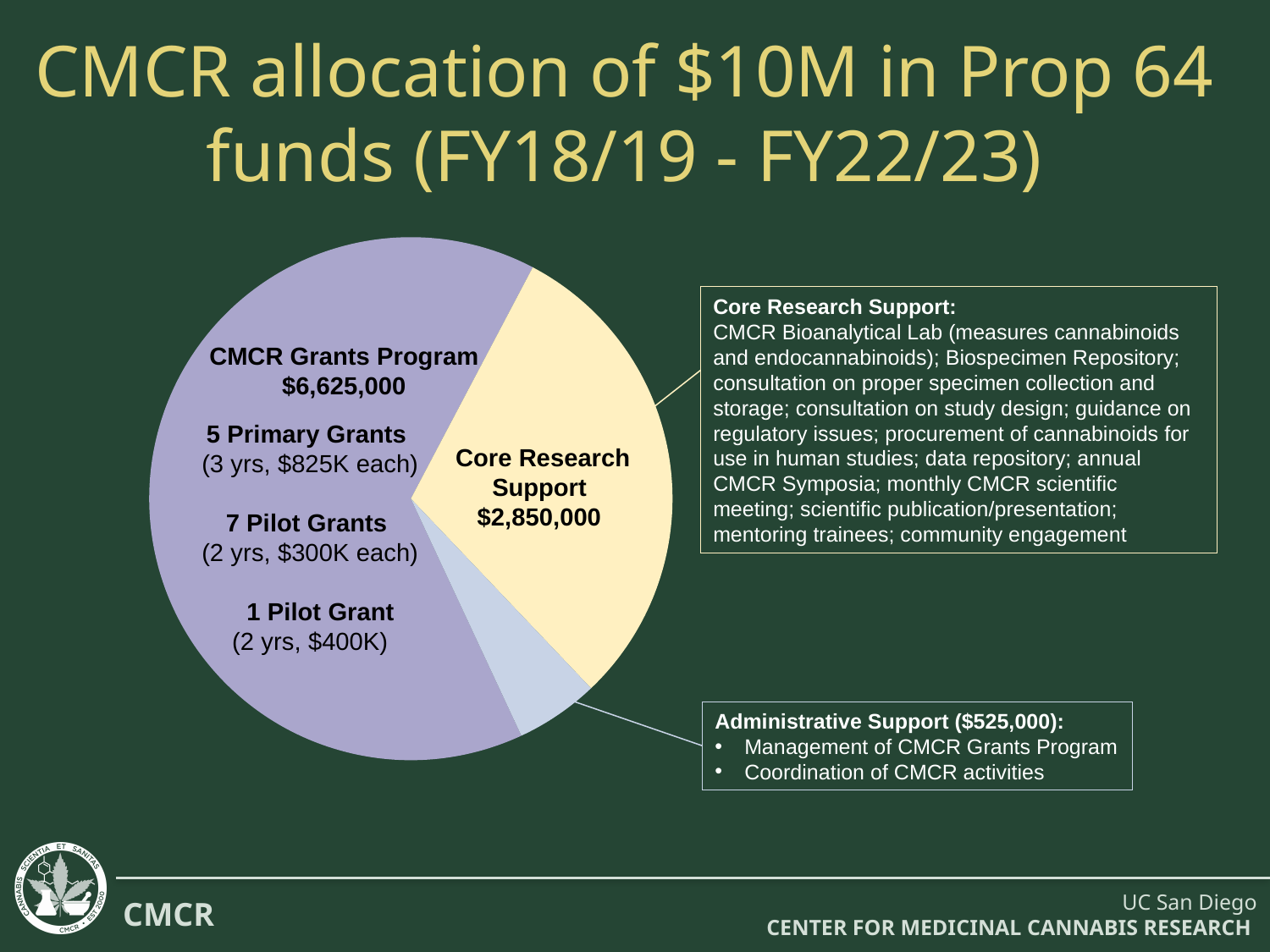
How many Primary Grants are listed under the CMCR Grants Program? 5 How many slices does the pie chart have? 3 What is the value of the Administrative Support slice? $525,000 What is the value of the Core Research Support slice? $2,850,000 Which slice of the pie chart is the largest? CMCR Grants Program Which slice of the pie chart is the smallest? Administrative Support What is the value of the CMCR Grants Program slice? $6,625,000 Which is larger, Core Research Support or Administrative Support? Core Research Support What is the difference between the CMCR Grants Program and Core Research Support amounts? $3,775,000 What share of the total does the Core Research Support slice represent? 28.5% What is the total of the three slices in the pie chart? $10,000,000 What kind of chart is shown on the slide? Pie chart